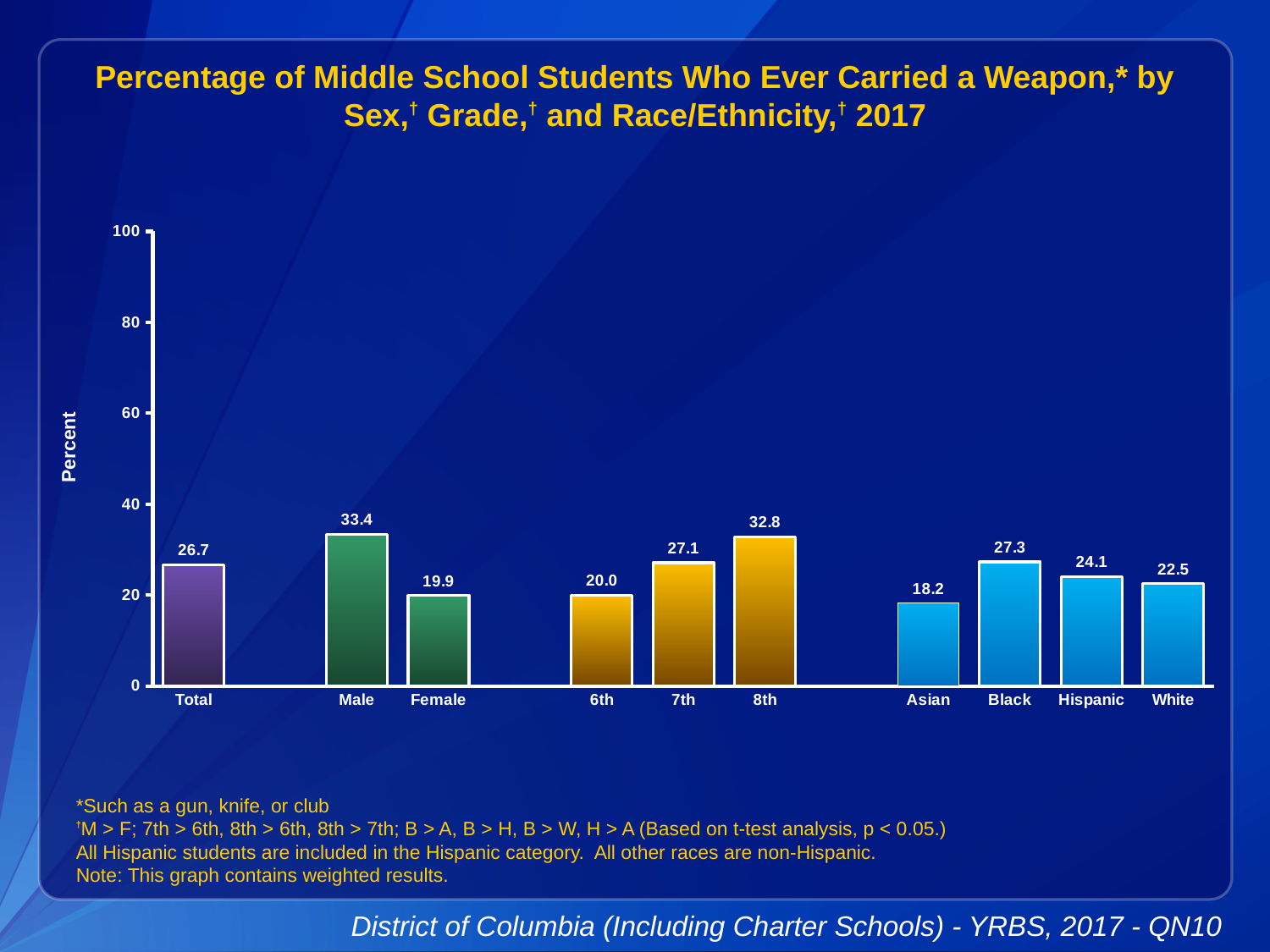
Which is larger, the value for Black or the value for White? Black What is the value for Hispanic? 24.1 What is the difference between the Male and Female values? 13.5 What kind of chart is this? bar chart What is the value for 8th grade? 32.8 How many categories are shown on the x axis? 10 Is the value for 6th grade greater or less than 40? less What is the value for Female? 19.9 What is the label of the y axis? Percent What is the value for Total? 26.7 Which category has the highest value? Male Which category has the lowest value? Asian